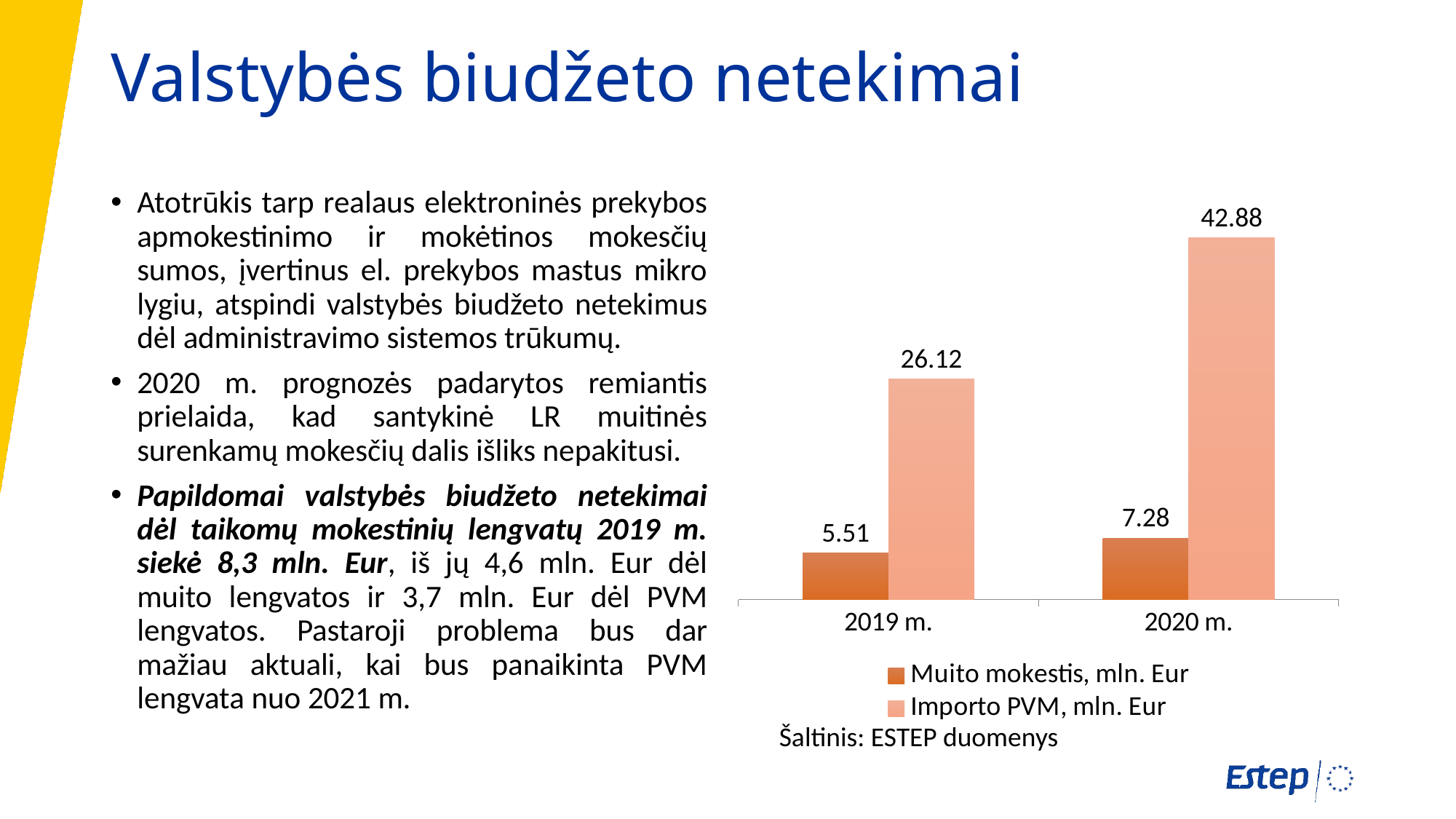
What is the value of Importo PVM, mln. Eur for 2020 m.? 42.88 Which year has the higher value for Importo PVM, mln. Eur? 2020 m. What kind of chart is shown on the slide? Bar chart Which is larger: Muito mokestis, mln. Eur in 2020 m. or Muito mokestis, mln. Eur in 2019 m.? 2020 m. How many series does the chart legend list? 2 Which series has the lowest value in 2019 m.? Muito mokestis, mln. Eur Do the values for Muito mokestis, mln. Eur rise or fall from 2019 m. to 2020 m.? Rise What is the value of Muito mokestis, mln. Eur for 2019 m.? 5.51 What is the value of Muito mokestis, mln. Eur for 2020 m.? 7.28 How many categories are shown on the x axis of the chart? 2 What is the difference between Importo PVM, mln. Eur in 2020 m. and in 2019 m.? 16.76 What is the value of Importo PVM, mln. Eur for 2019 m.? 26.12